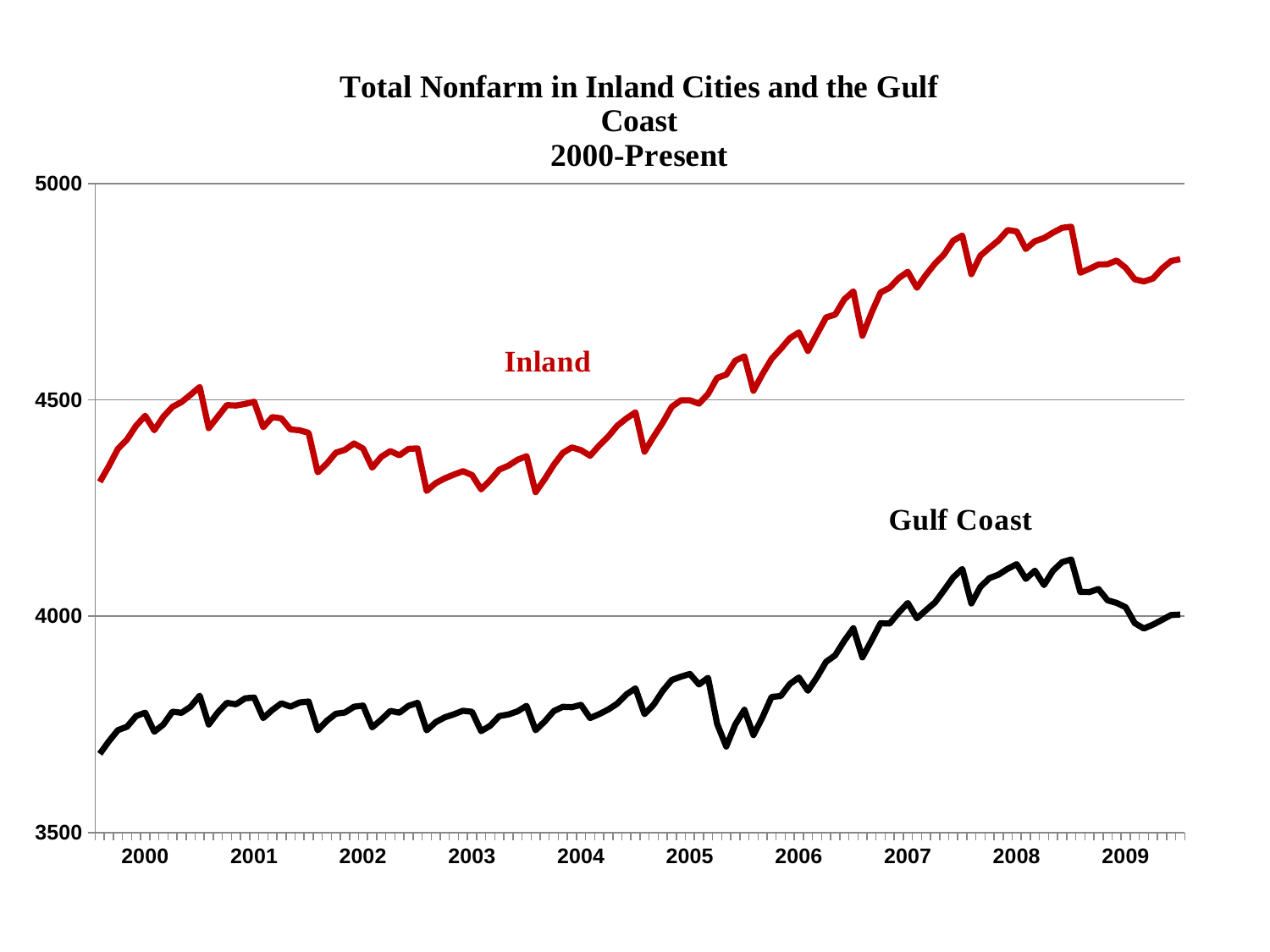
Which series is drawn in red? Inland How many data series are plotted on the chart? 2 What kind of chart is shown on the slide? Line chart Is the value for Gulf Coast in 2008 greater or less than 4000? greater Is the value for Inland in 2008 greater or less than 4500? greater Is the value for Gulf Coast in 2000 greater or less than 4000? less Which series has higher values throughout the period, Inland or Gulf Coast? Inland How many year labels are shown on the x axis? 10 What is the title of the chart? Total Nonfarm in Inland Cities and the Gulf Coast 2000-Present Does the Gulf Coast series rise or fall between 2008 and 2009? fall Does the Inland series rise or fall between 2005 and 2008? rise